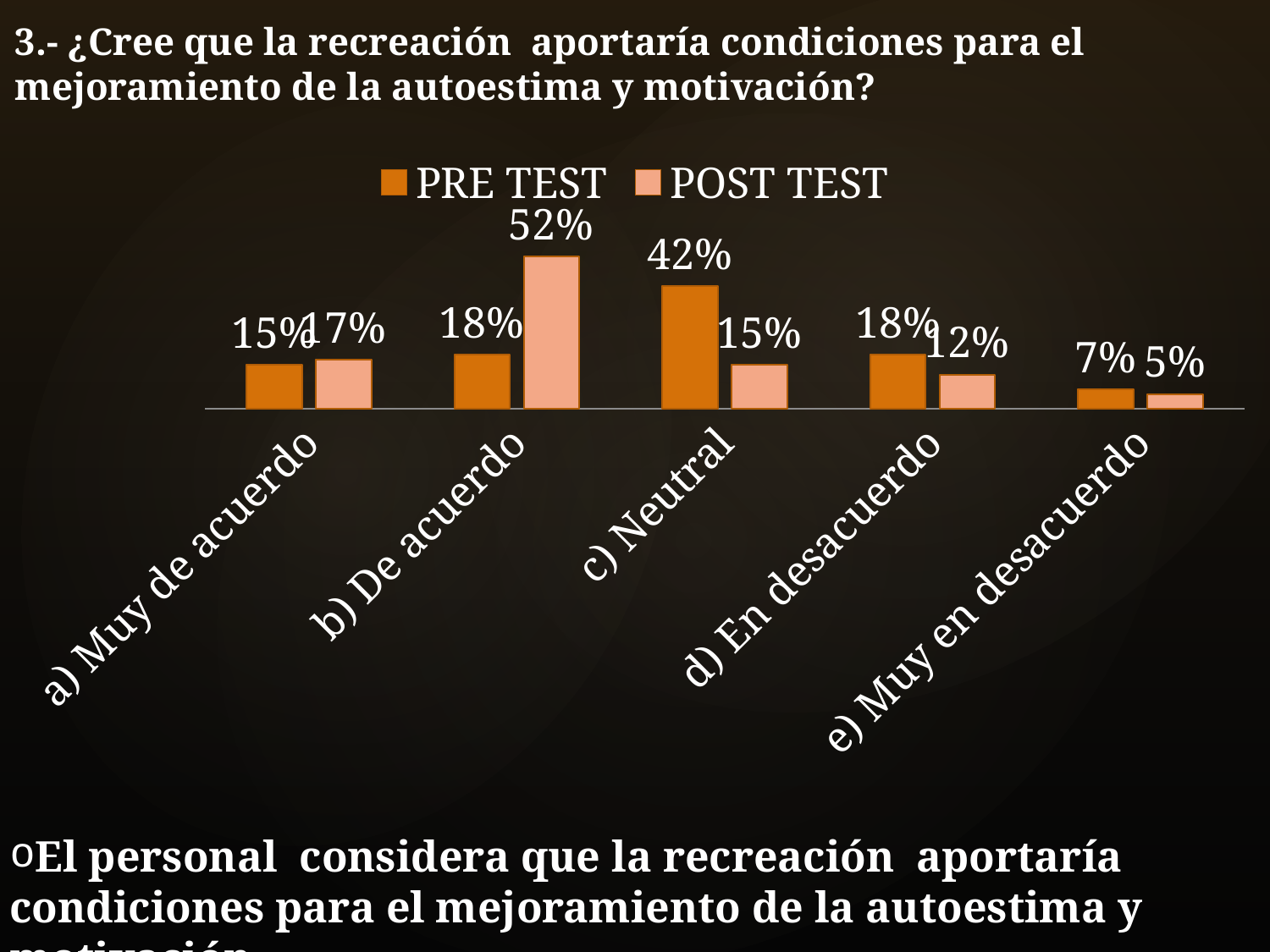
What is the difference between the POST TEST and PRE TEST values for b) De acuerdo? 34% How many categories are shown on the x axis? 5 What is the POST TEST value for e) Muy en desacuerdo? 5% Which category has the lowest PRE TEST value? e) Muy en desacuerdo What is the POST TEST value for b) De acuerdo? 52% How many series does the legend list? 2 For c) Neutral, which is larger, the PRE TEST value or the POST TEST value? PRE TEST What are the two series named in the legend? PRE TEST and POST TEST What kind of chart is shown on the slide? Bar chart Which category has the highest POST TEST value? b) De acuerdo What is the PRE TEST value for c) Neutral? 42% What is the PRE TEST value for d) En desacuerdo? 18%